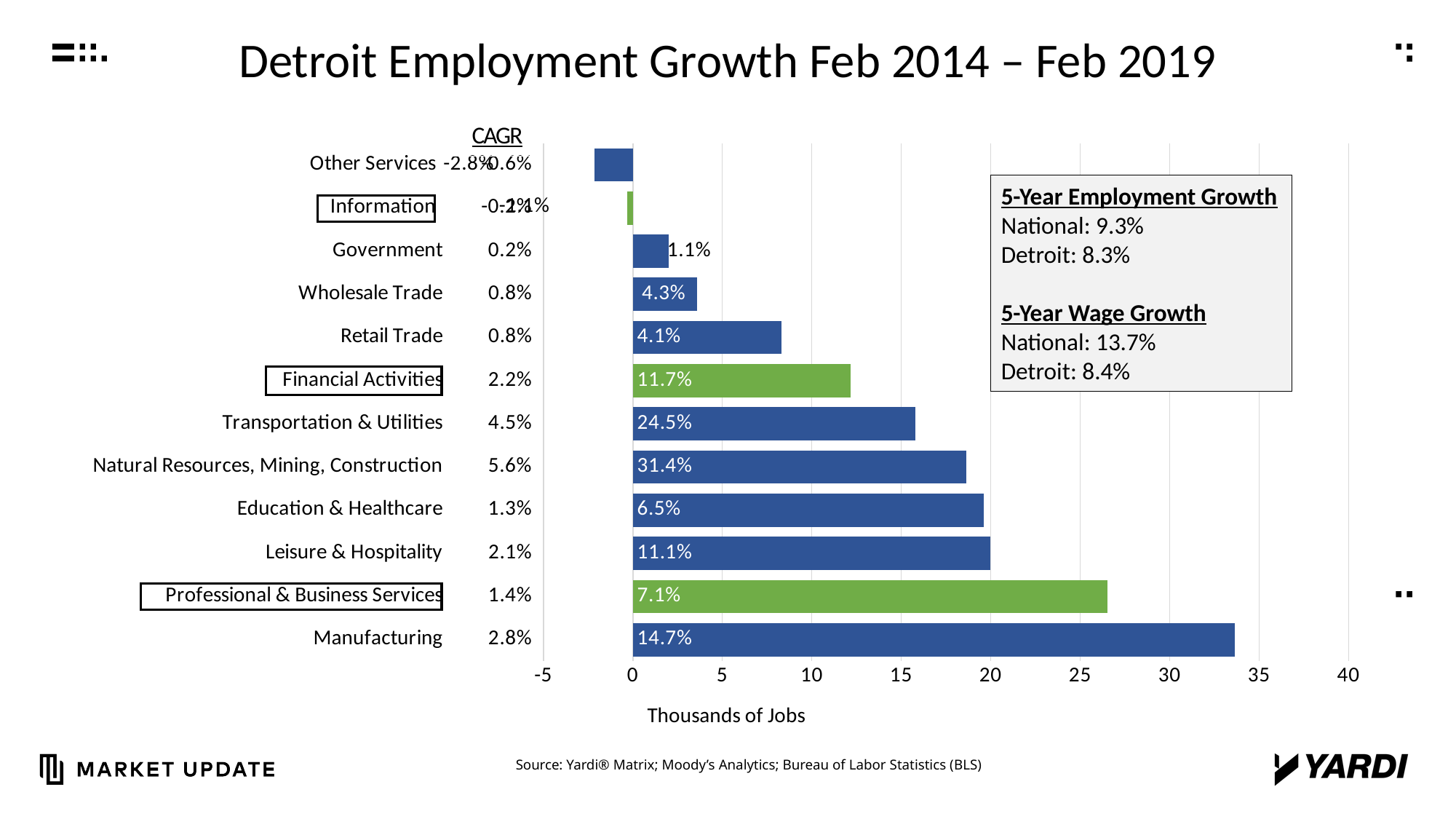
Which sector has the lowest value (largest job loss) in the chart? Other Services How many sectors are plotted in the chart? 12 What is the label on the horizontal axis of the chart? Thousands of Jobs What is the CAGR shown for Natural Resources, Mining, Construction? 5.6% Is the value for Manufacturing greater or less than 30 thousand jobs? greater Is the value for Financial Activities greater or less than 10 thousand jobs? greater What is the CAGR shown for Financial Activities? 2.2% What kind of chart is shown on the slide? bar chart Which bar is longer, Manufacturing or Professional & Business Services? Manufacturing What percentage is printed on the Transportation & Utilities bar? 24.5% Which sector has the longest bar (most thousands of jobs added)? Manufacturing What percentage is printed on the Manufacturing bar? 14.7%